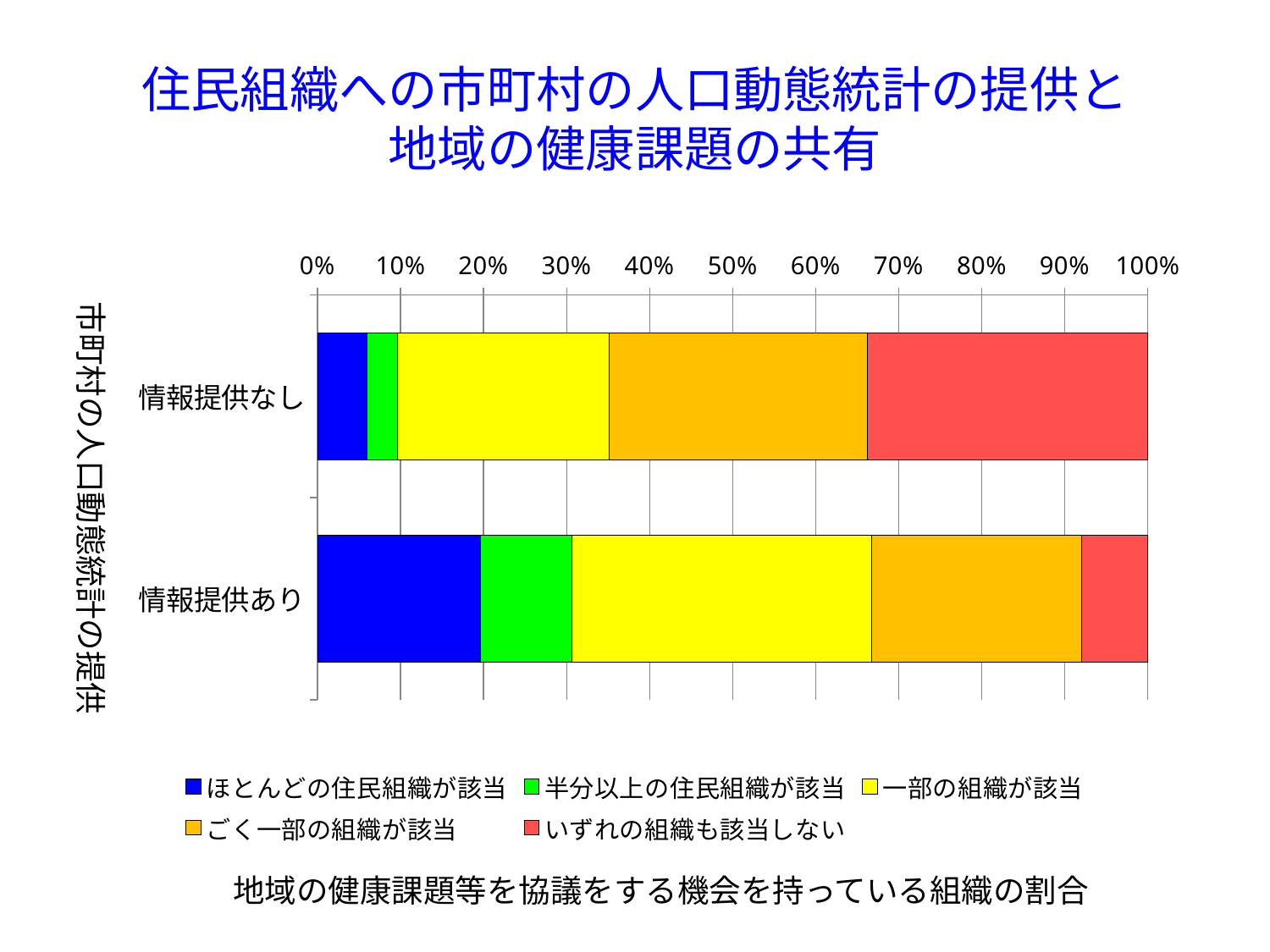
Is the ほとんどの住民組織が該当 (blue) share for 情報提供なし greater or less than 10%? less How many series does the legend list? 5 What is the title of the chart on the slide? 住民組織への市町村の人口動態統計の提供と地域の健康課題の共有 Is the いずれの組織も該当しない (red) share for 情報提供あり greater or less than 20%? less Which category has the larger いずれの組織も該当しない (red) segment, 情報提供なし or 情報提供あり? 情報提供なし How many categories (bars) are plotted on the chart? 2 What kind of chart is shown on the slide? stacked bar chart Which category has the larger ほとんどの住民組織が該当 (blue) segment, 情報提供なし or 情報提供あり? 情報提供あり What colour represents いずれの組織も該当しない in the legend? red Is the いずれの組織も該当しない (red) share for 情報提供なし greater or less than 20%? greater Which category has the larger 半分以上の住民組織が該当 (green) segment, 情報提供なし or 情報提供あり? 情報提供あり